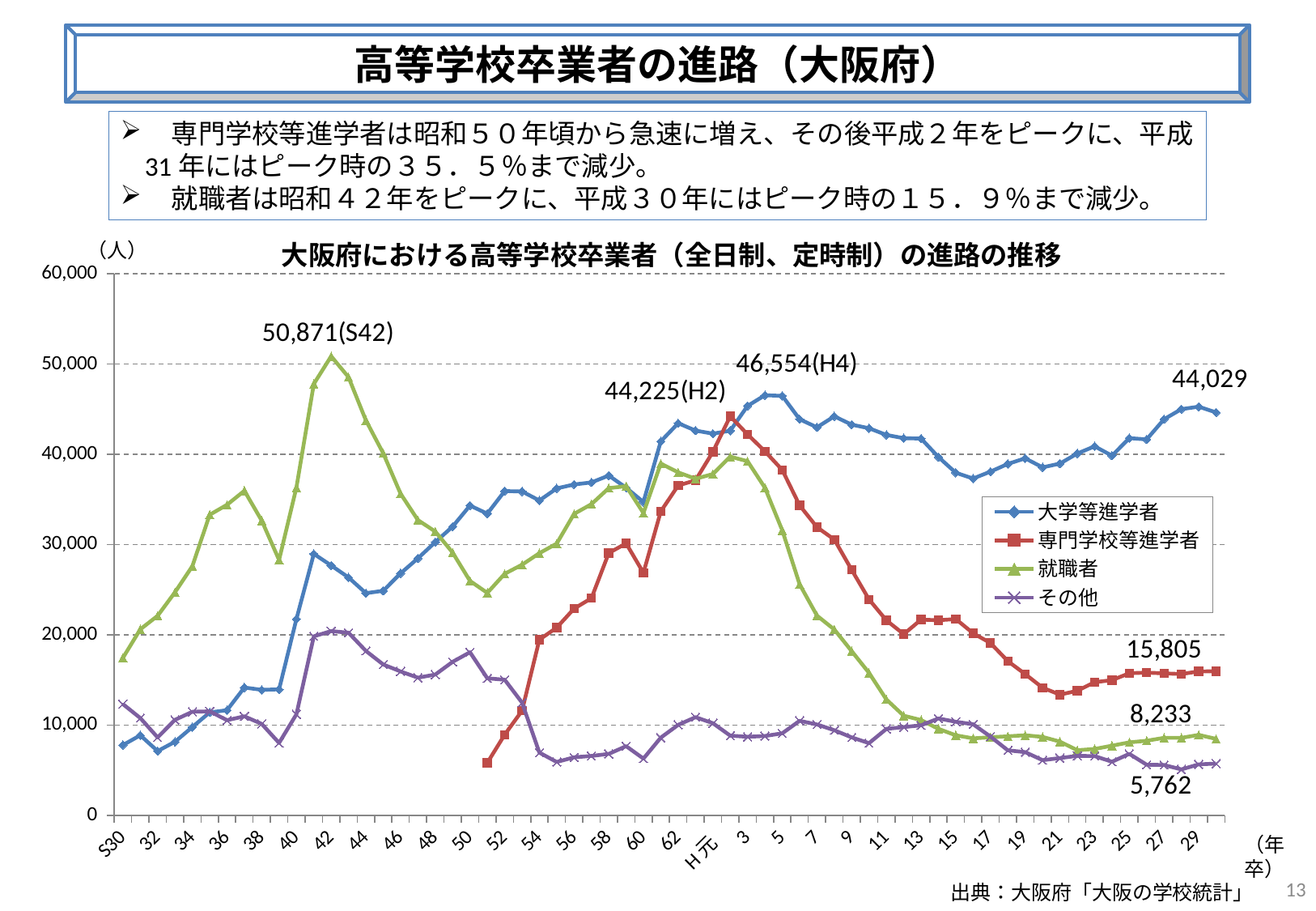
What kind of chart is shown on the slide? line chart What is the peak value labelled for 大学等進学者? 46,554 (H4) What is the peak value labelled for 専門学校等進学者? 44,225 (H2) Is the value for 就職者 at S30 greater or less than 20,000? less What is the peak value labelled for 就職者, and in which year? 50,871 (S42) What is the final labelled value for 専門学校等進学者? 15,805 How many series does the legend list? 4 What is the final labelled value for その他? 5,762 At the right end of the chart, which is larger: the value for 就職者 (8,233) or the value for その他 (5,762)? 就職者 Which series reaches the highest labelled peak value on the chart? 就職者 What is the final labelled value for 大学等進学者 at the right end of the chart? 44,029 What is the difference between the labelled peak of 大学等進学者 (46,554) and the labelled peak of 専門学校等進学者 (44,225)? 2,329